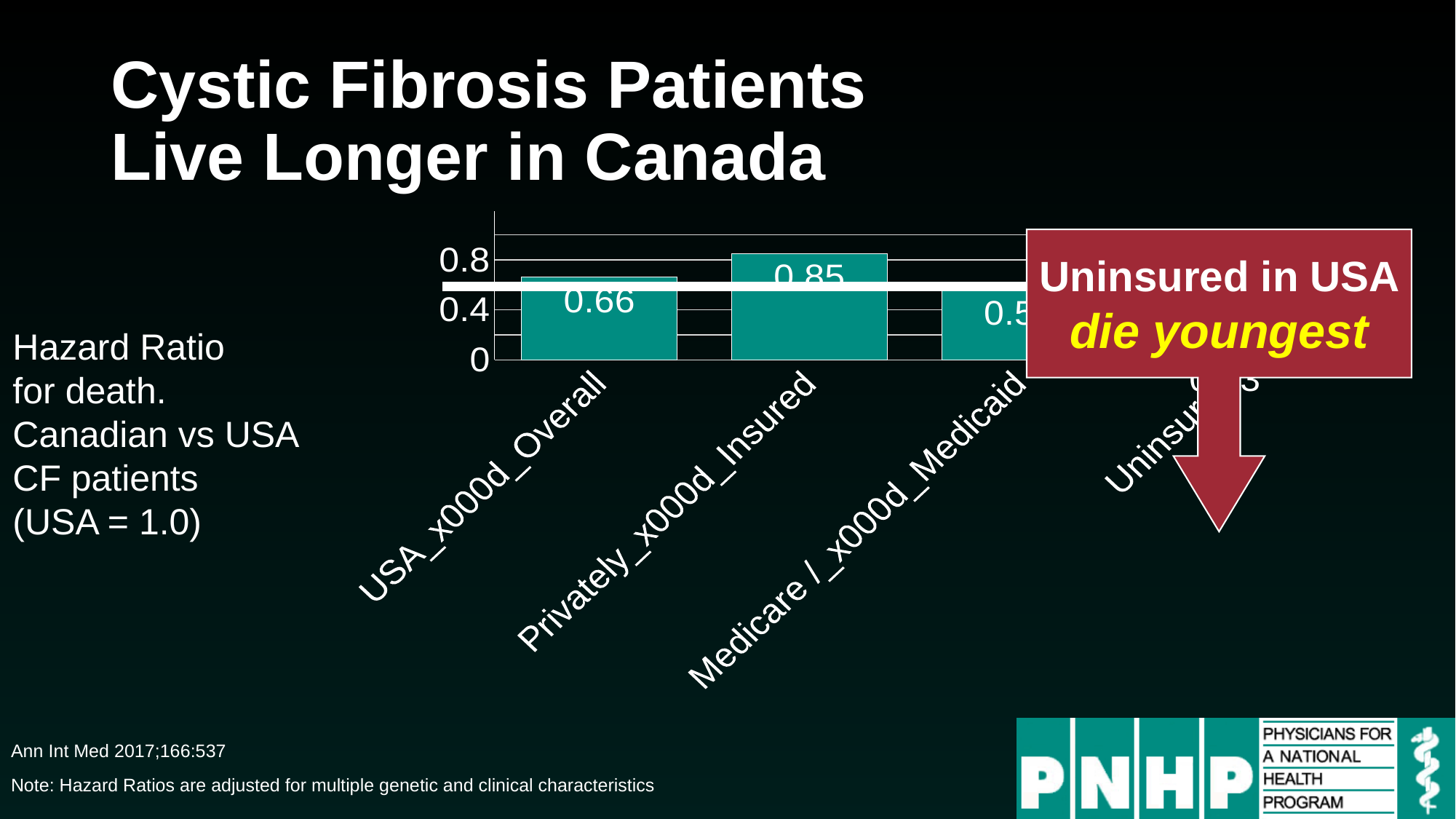
Which is larger, the value for Privately Insured or the value for USA Overall? Privately Insured Is the value for Privately Insured greater or less than 0.8? greater What is the difference between the Privately Insured value and the USA Overall value? 0.19 What kind of chart is shown on the slide? bar chart What is the highest tick value labelled on the vertical axis? 0.8 Is the value for Medicare / Medicaid greater or less than 0.8? less What is the hazard ratio value shown for Privately Insured? 0.85 What colour are the bars in the chart? teal What is the hazard ratio value shown for USA Overall? 0.66 Is the value for USA Overall greater or less than 0.8? less Which is larger, the value for USA Overall or the value for Medicare / Medicaid? USA Overall